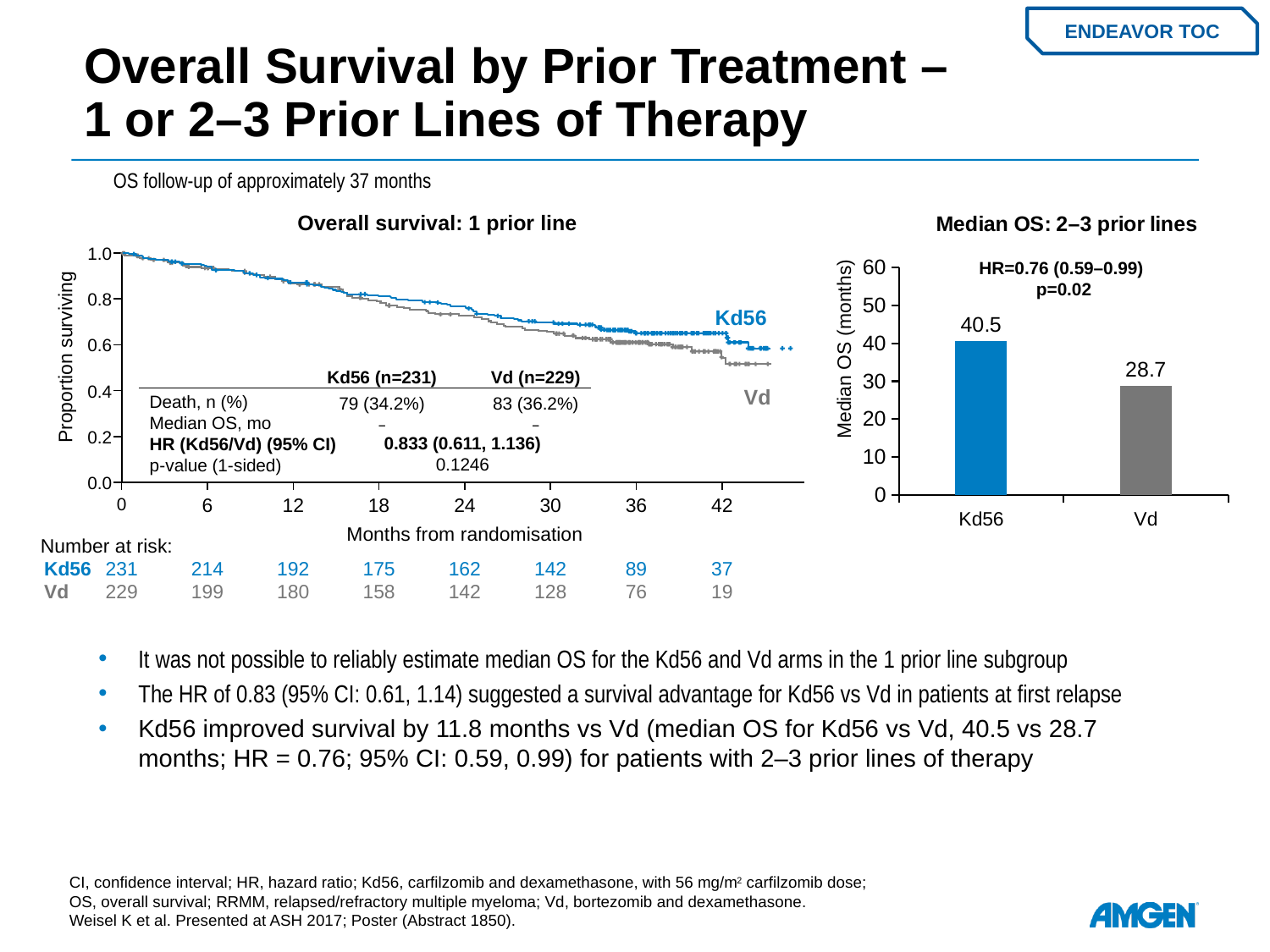
In the 'Overall survival: 1 prior line' chart, what is the HR (Kd56/Vd) with 95% CI shown in the table? 0.833 (0.611, 1.136) In the 'Median OS: 2–3 prior lines' chart, which arm has the higher median OS? Kd56 In the 'Median OS: 2–3 prior lines' chart, what is the median OS for Vd? 28.7 In the 'Median OS: 2–3 prior lines' chart, how many bars are plotted? 2 In the 'Overall survival: 1 prior line' chart, how many treatment arms are plotted? 2 In the 'Median OS: 2–3 prior lines' chart, is the value for Vd greater or less than 20? greater What kind of chart is 'Median OS: 2–3 prior lines'? Bar chart In the 'Overall survival: 1 prior line' chart, how many patients in the Vd arm were at risk at 24 months? 142 In the 'Overall survival: 1 prior line' chart, do the survival curves rise or fall as months from randomisation increase? Fall In the 'Median OS: 2–3 prior lines' chart, what is the median OS for Kd56? 40.5 In the 'Median OS: 2–3 prior lines' chart, what is the difference in median OS between Kd56 and Vd? 11.8 In the 'Overall survival: 1 prior line' chart, how many patients in the Kd56 arm were at risk at 0 months? 231